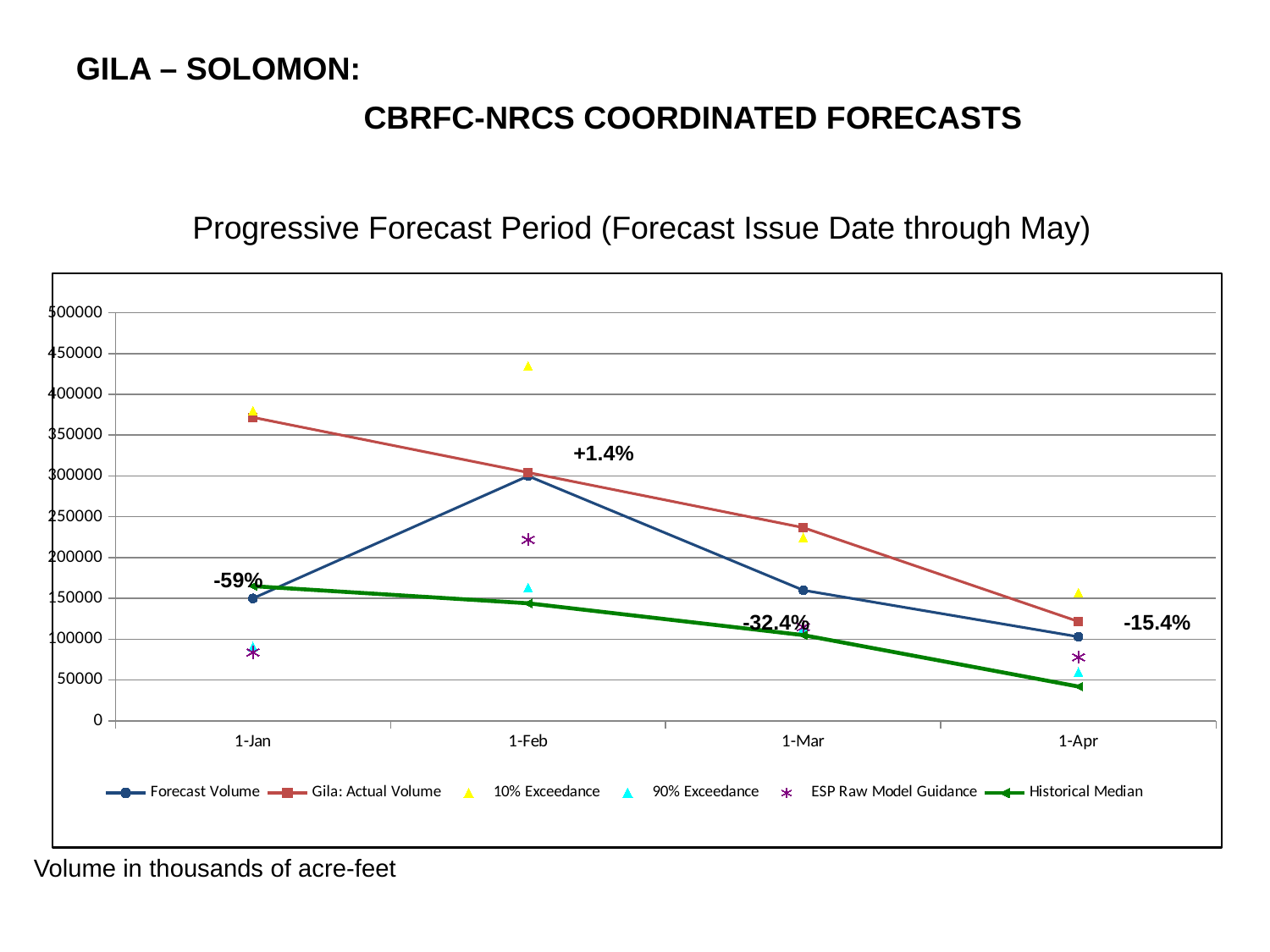
How many dates are plotted along the x axis of the chart? 4 What percentage label is printed next to the 1-Jan point on the chart? -59% Is the Gila: Actual Volume value at 1-Jan greater or less than 350000? greater Does the Gila: Actual Volume series rise or fall from 1-Jan to 1-Apr? fall What kind of chart is shown on the slide? line chart What percentage label is printed near the 1-Mar point on the chart? -32.4% At 1-Mar, which is larger: Gila: Actual Volume or Forecast Volume? Gila: Actual Volume What percentage label is printed next to the 1-Apr point on the chart? -15.4% What is the title of the chart? Progressive Forecast Period (Forecast Issue Date through May) How many series does the chart's legend list? 6 Is the Forecast Volume value at 1-Jan greater or less than 200000? less Is the 10% Exceedance value at 1-Feb greater or less than 400000? greater